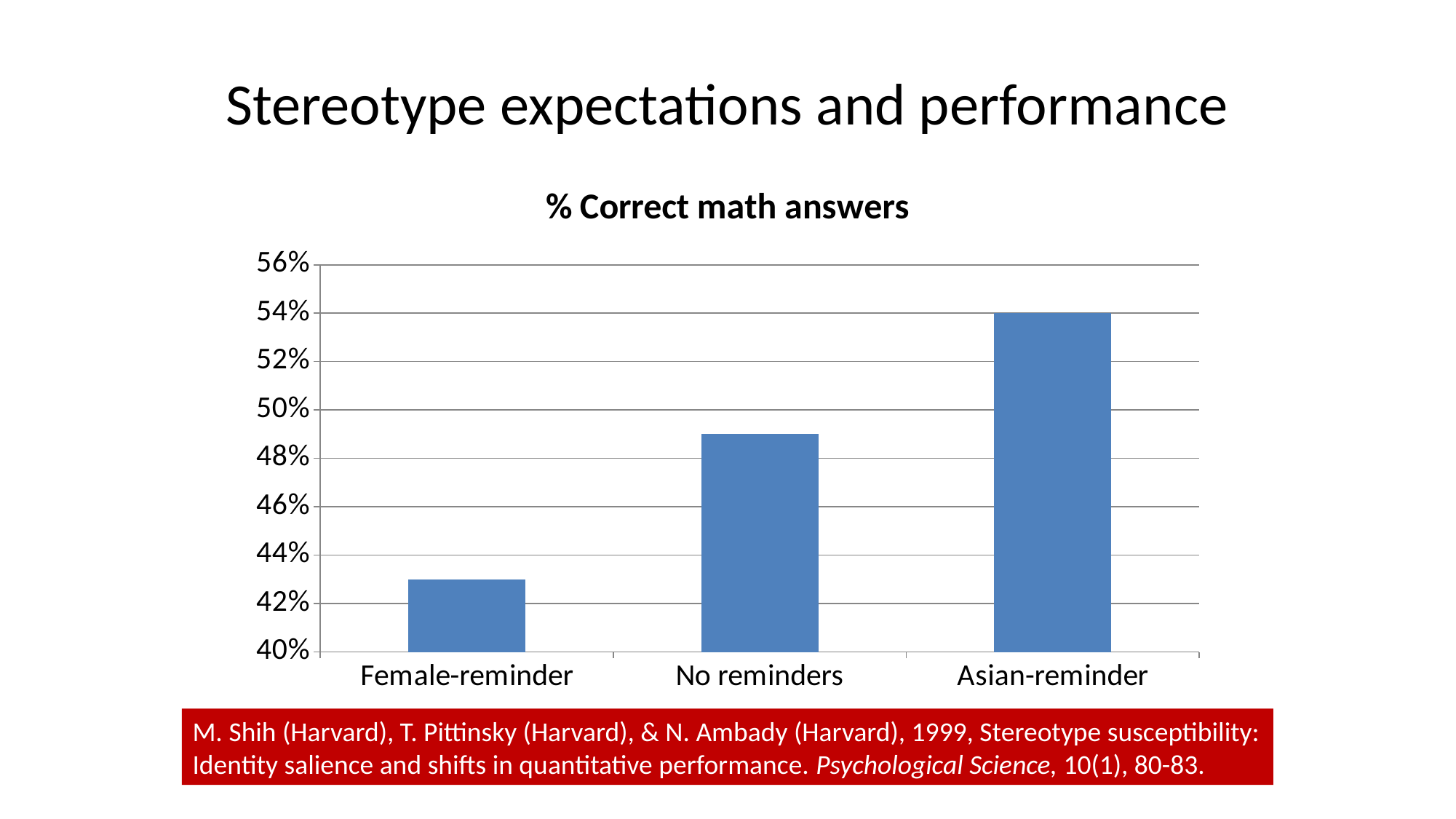
What is the value for Asian-reminder? 54% Which category has the lowest % correct math answers? Female-reminder How many categories are plotted in the chart? 3 What is the lowest value shown on the vertical axis? 40% Which is larger, the value for No reminders or the value for Female-reminder? No reminders What kind of chart is shown on the slide? bar chart What is the title of the chart? % Correct math answers Is the value for Female-reminder greater or less than 44%? less Do the values rise or fall from left to right across the categories? rise Which category has the highest % correct math answers? Asian-reminder Is the value for No reminders greater or less than 48%? greater Is the value for Female-reminder greater or less than 42%? greater